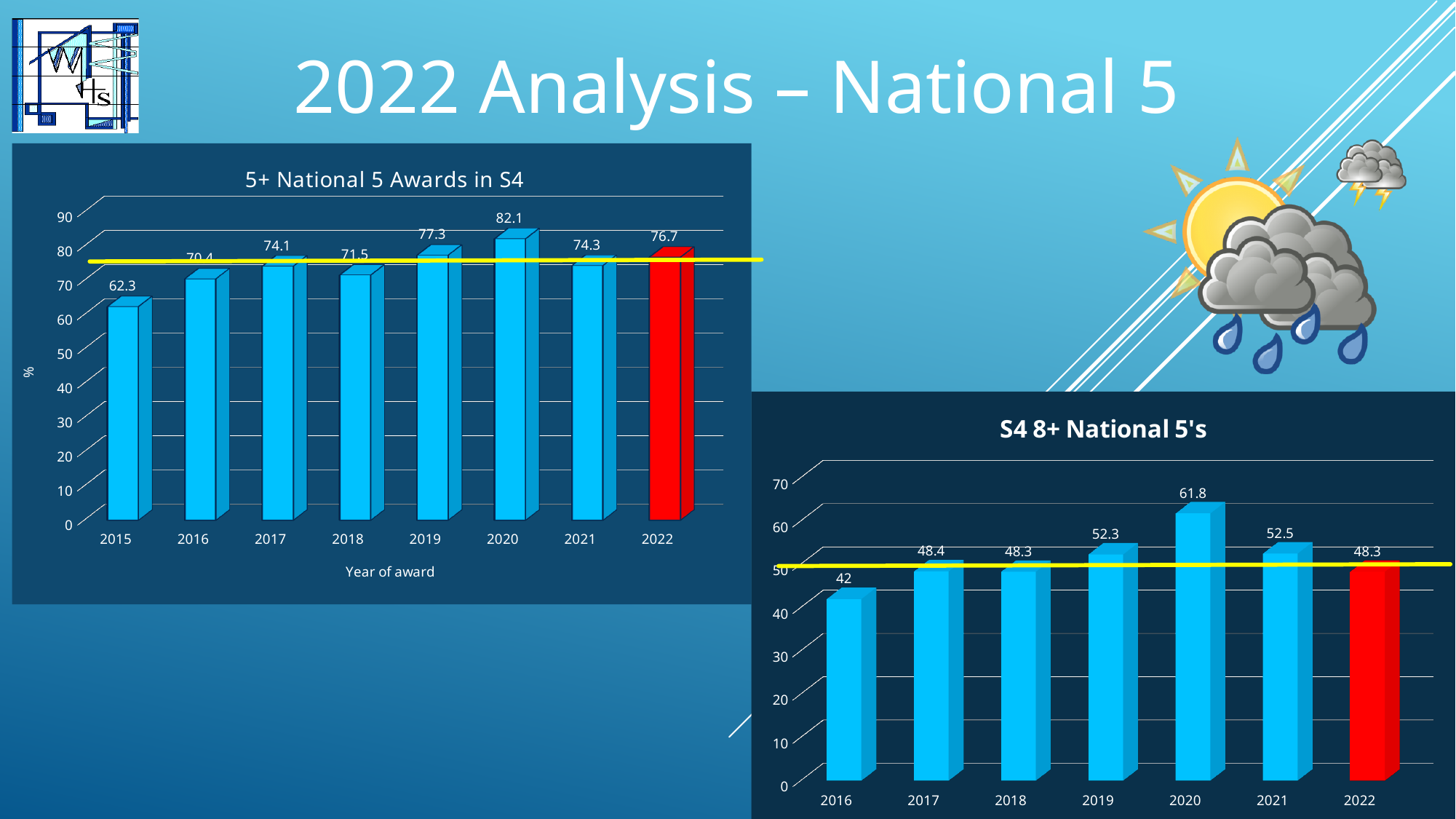
In the '5+ National 5 Awards in S4' chart, which year has the lowest value? 2015 In the 'S4 8+ National 5's' chart, what is the value for 2020? 61.8 In the 'S4 8+ National 5's' chart, is the value for 2021 larger than the value for 2022? Yes In the '5+ National 5 Awards in S4' chart, what is the difference between the 2020 and 2022 values? 5.4 In the '5+ National 5 Awards in S4' chart, which year has the highest value? 2020 In the '5+ National 5 Awards in S4' chart, what is the value for 2022? 76.7 What type of chart is the 'S4 8+ National 5's' chart? Bar chart In the '5+ National 5 Awards in S4' chart, what is the label on the x axis? Year of award In the 'S4 8+ National 5's' chart, which year has the lowest value? 2016 In the 'S4 8+ National 5's' chart, how many years are plotted? 7 In the '5+ National 5 Awards in S4' chart, how many years are plotted? 8 In the 'S4 8+ National 5's' chart, what is the difference between the 2020 and 2016 values? 19.8